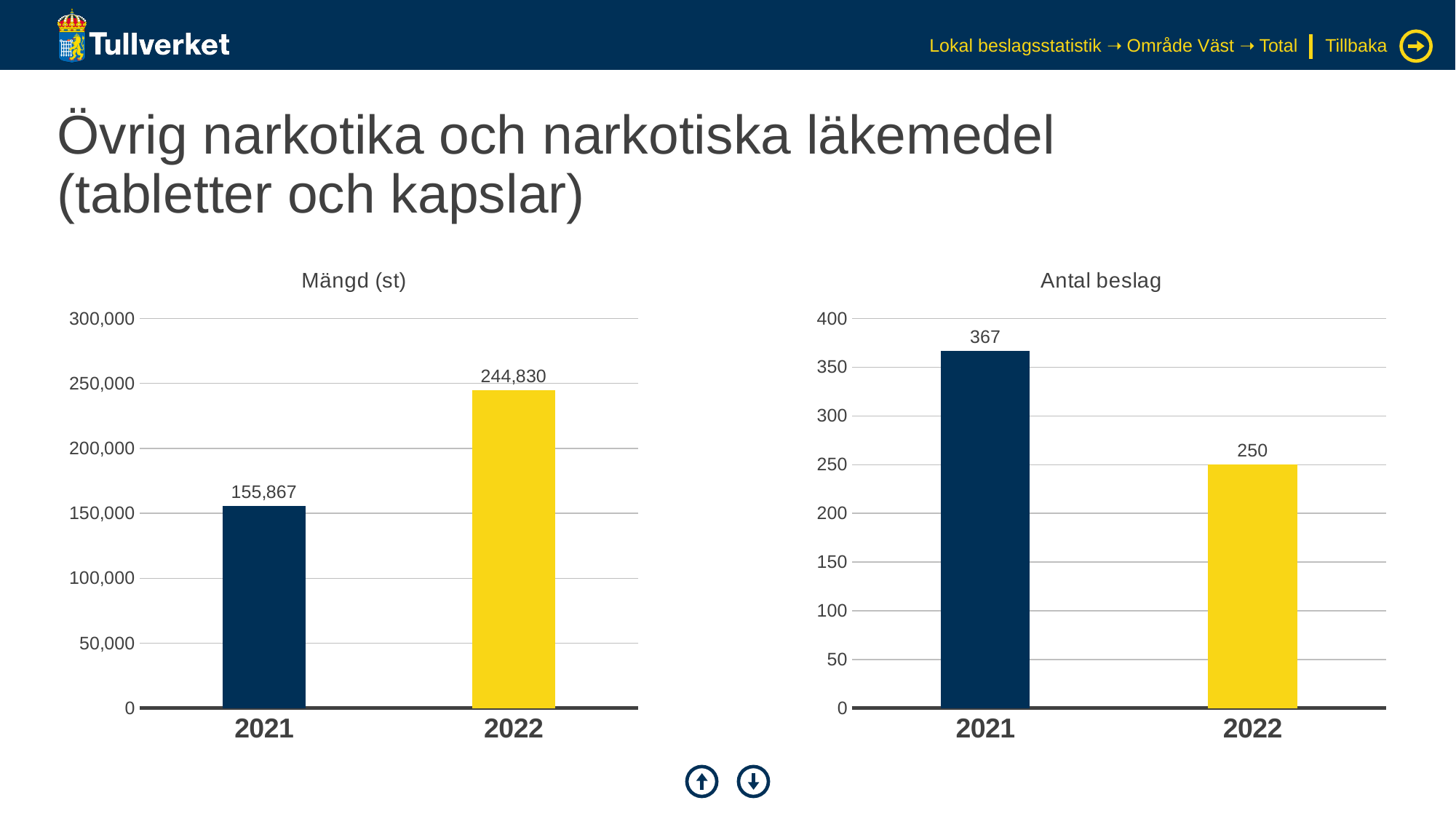
In the 'Antal beslag' chart, is the value for 2021 greater or less than 350? greater In the 'Mängd (st)' chart, what is the difference between the 2022 and 2021 values? 88,963 In the 'Mängd (st)' chart, what is the value for 2022? 244,830 In the 'Antal beslag' chart, which year has the lowest value? 2022 In the 'Antal beslag' chart, what is the difference between the 2021 and 2022 values? 117 What kind of chart is the 'Antal beslag' chart? bar chart In the 'Mängd (st)' chart, what is the value for 2021? 155,867 In the 'Mängd (st)' chart, which year has the highest value? 2022 How many categories are shown on the x axis of the 'Mängd (st)' chart? 2 In the 'Mängd (st)' chart, do the values rise or fall from 2021 to 2022? rise In the 'Antal beslag' chart, what is the value for 2022? 250 In the 'Antal beslag' chart, what is the value for 2021? 367